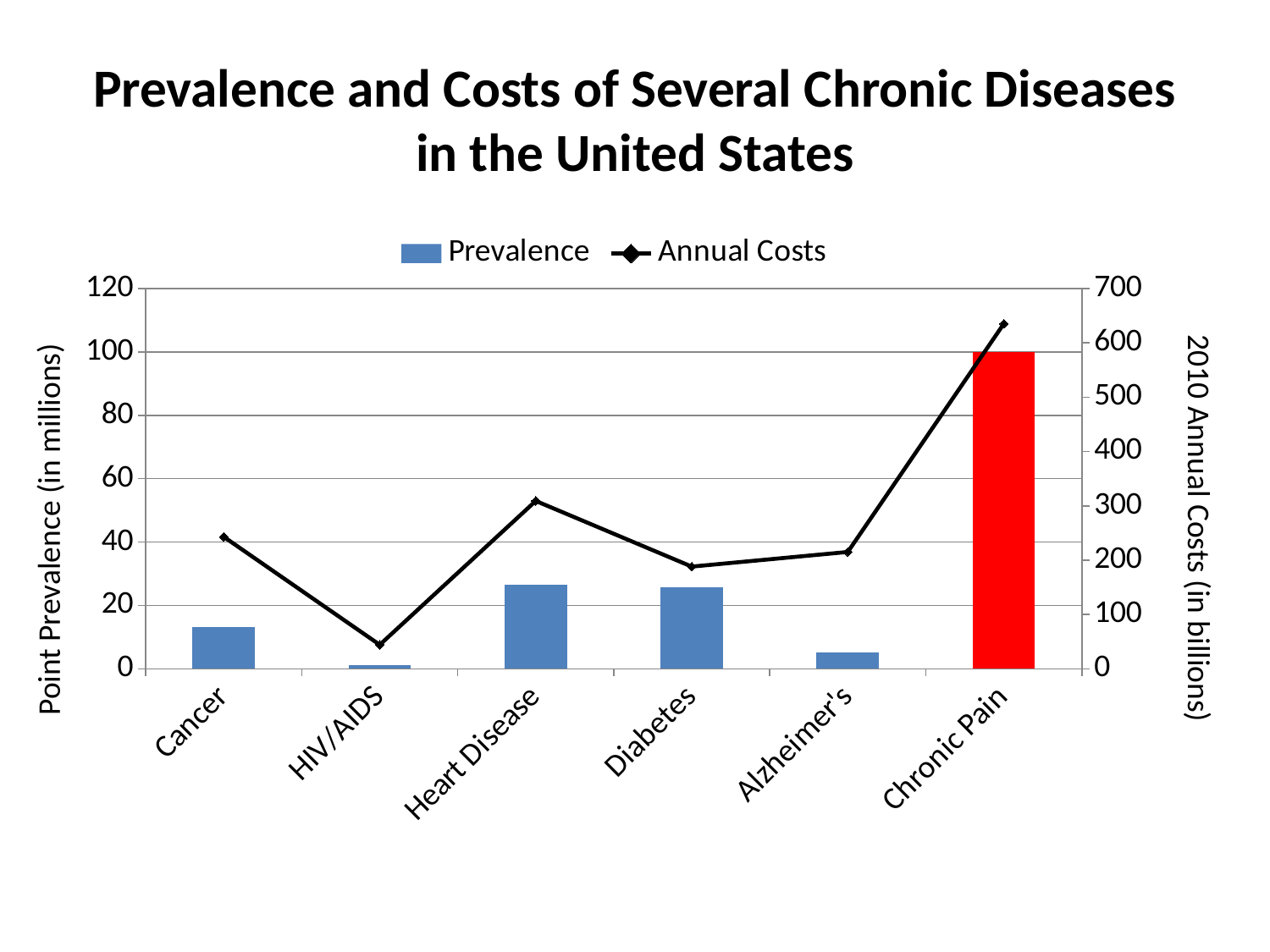
Which disease has the lowest annual costs on the line series? HIV/AIDS Is the annual costs value for Chronic Pain greater or less than 600? greater Is the prevalence value for Alzheimer's greater or less than 20? less How many series does the legend list? 2 How many disease categories are shown on the x axis? 6 Which disease has the highest prevalence bar? Chronic Pain Is the prevalence value for Heart Disease greater or less than 20? greater What is the label of the right-hand vertical axis? 2010 Annual Costs (in billions) Which disease has the highest annual costs on the line series? Chronic Pain Which has the larger prevalence, Cancer or Alzheimer's? Cancer Which disease has the lowest prevalence bar? HIV/AIDS What is the title of the chart? Prevalence and Costs of Several Chronic Diseases in the United States